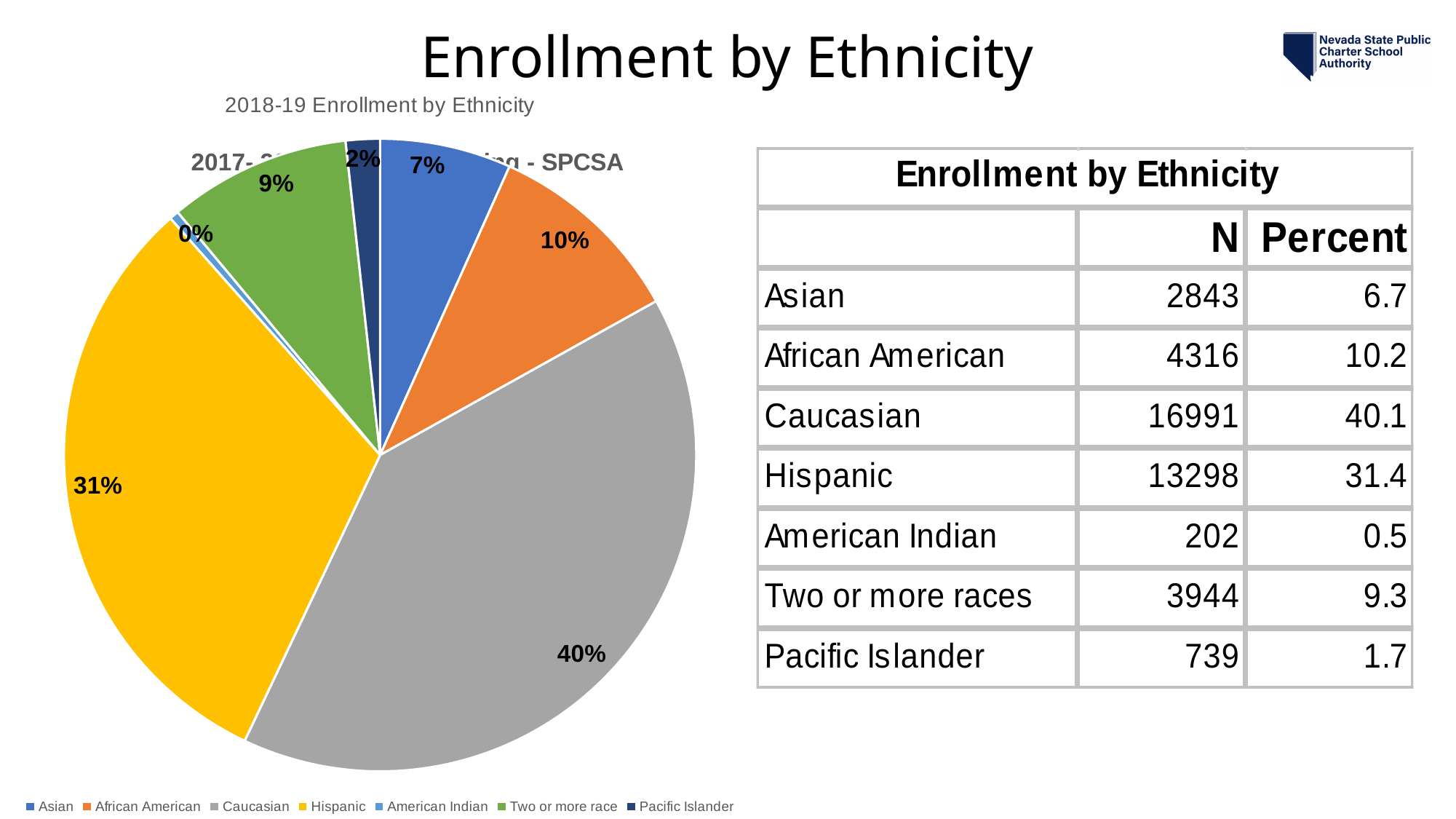
Which slice is larger, Asian or African American? African American What percentage of the pie does the Hispanic slice represent? 31% What percentage is shown for the Two or more race slice? 9% What percentage of the pie does the Caucasian slice represent? 40% What percentage is shown for the Pacific Islander slice? 2% What kind of chart is shown on the slide? pie chart Which category has the smallest slice of the pie? American Indian What is the difference in percentage points between the Caucasian and Hispanic slices? 9 What is the title of the chart? 2018-19 Enrollment by Ethnicity How many categories does the legend of the pie chart list? 7 What percentage is shown for the African American slice? 10% Which category has the largest slice of the pie? Caucasian